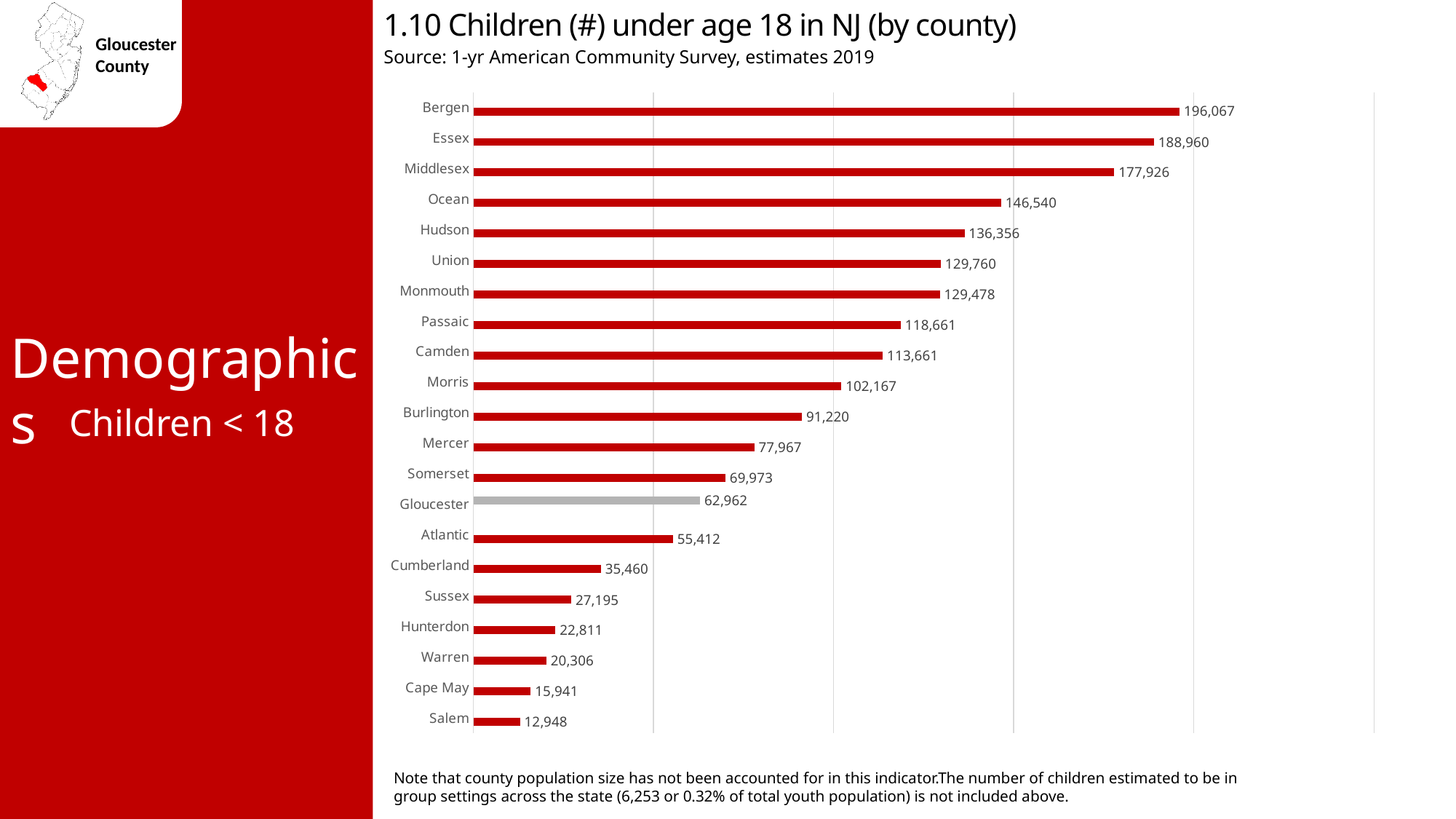
What is the difference between the number of children under 18 in Bergen and Essex counties? 7,107 Which county has the lowest number of children under age 18? Salem Which county has the highest number of children under age 18? Bergen What is the number of children under age 18 in Bergen County? 196,067 Which county's bar is shown in grey rather than red? Gloucester What is the difference between the number of children under 18 in Gloucester and Atlantic counties? 7,550 What is the number of children under age 18 in Camden County? 113,661 Which county has more children under age 18, Ocean or Hudson? Ocean What is the number of children under age 18 in Gloucester County? 62,962 Which county has more children under age 18, Sussex or Hunterdon? Sussex What kind of chart is shown on the slide? Bar chart How many counties are shown in the chart? 21